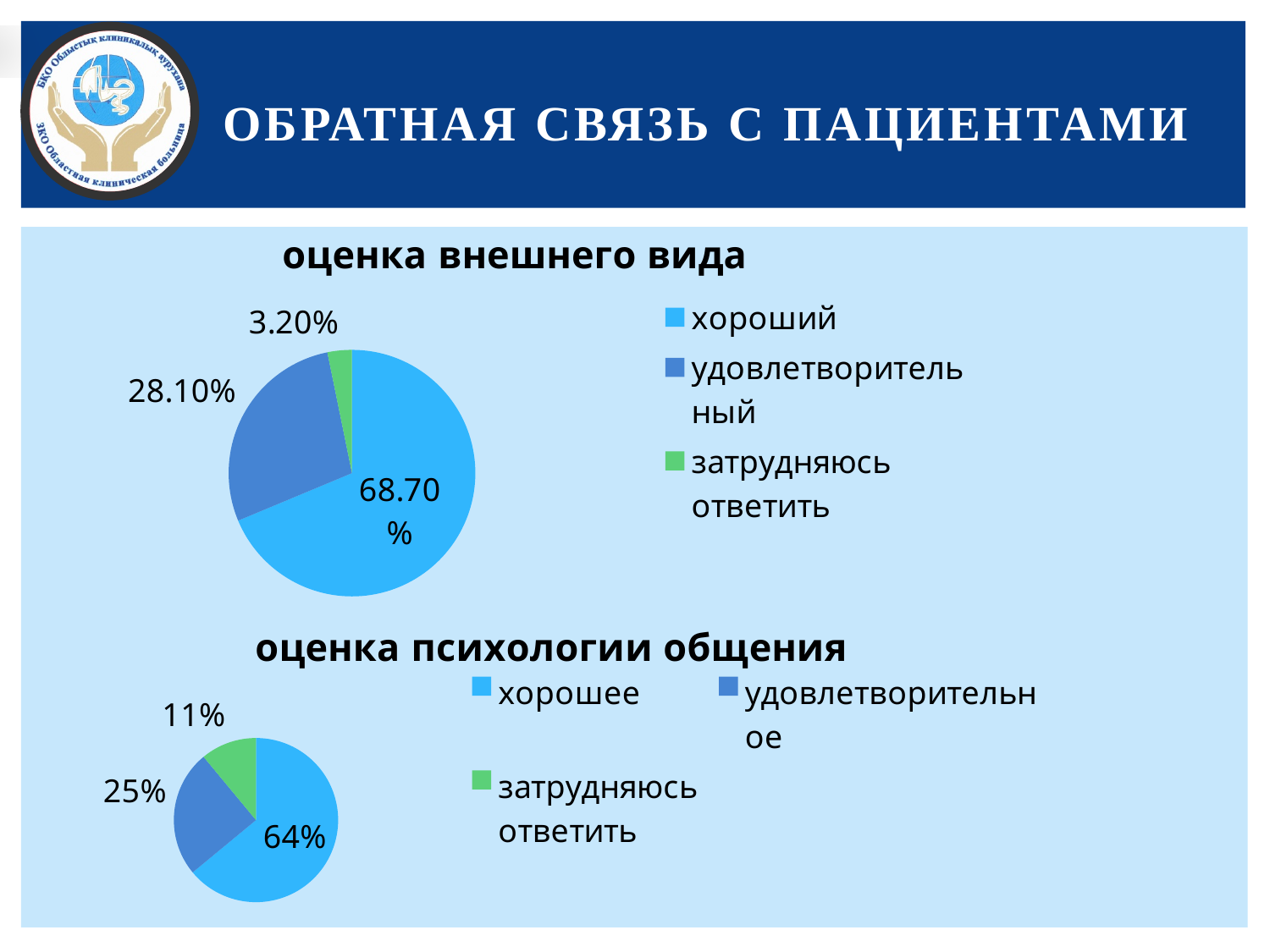
In the chart titled "оценка психологии общения", what is the difference between the "удовлетворительное" and "затрудняюсь ответить" shares? 14% In the chart titled "оценка психологии общения", what share of responses is "затрудняюсь ответить"? 11% How many categories does the legend of the chart titled "оценка психологии общения" list? 3 In the chart titled "оценка психологии общения", which is larger: "удовлетворительное" or "затрудняюсь ответить"? удовлетворительное In the chart titled "оценка внешнего вида", what share of responses is "затрудняюсь ответить"? 3.20% In the chart titled "оценка психологии общения", which category has the largest slice? хорошее In the chart titled "оценка внешнего вида", what share of responses is "хороший"? 68.70% In the chart titled "оценка внешнего вида", which category has the smallest slice? затрудняюсь ответить In the chart titled "оценка внешнего вида", what share of responses is "удовлетворительный"? 28.10% What type of chart is the chart titled "оценка внешнего вида"? pie chart In the chart titled "оценка психологии общения", what share of responses is "хорошее"? 64% In the chart titled "оценка внешнего вида", what is the difference between the "хороший" and "удовлетворительный" shares? 40.60%